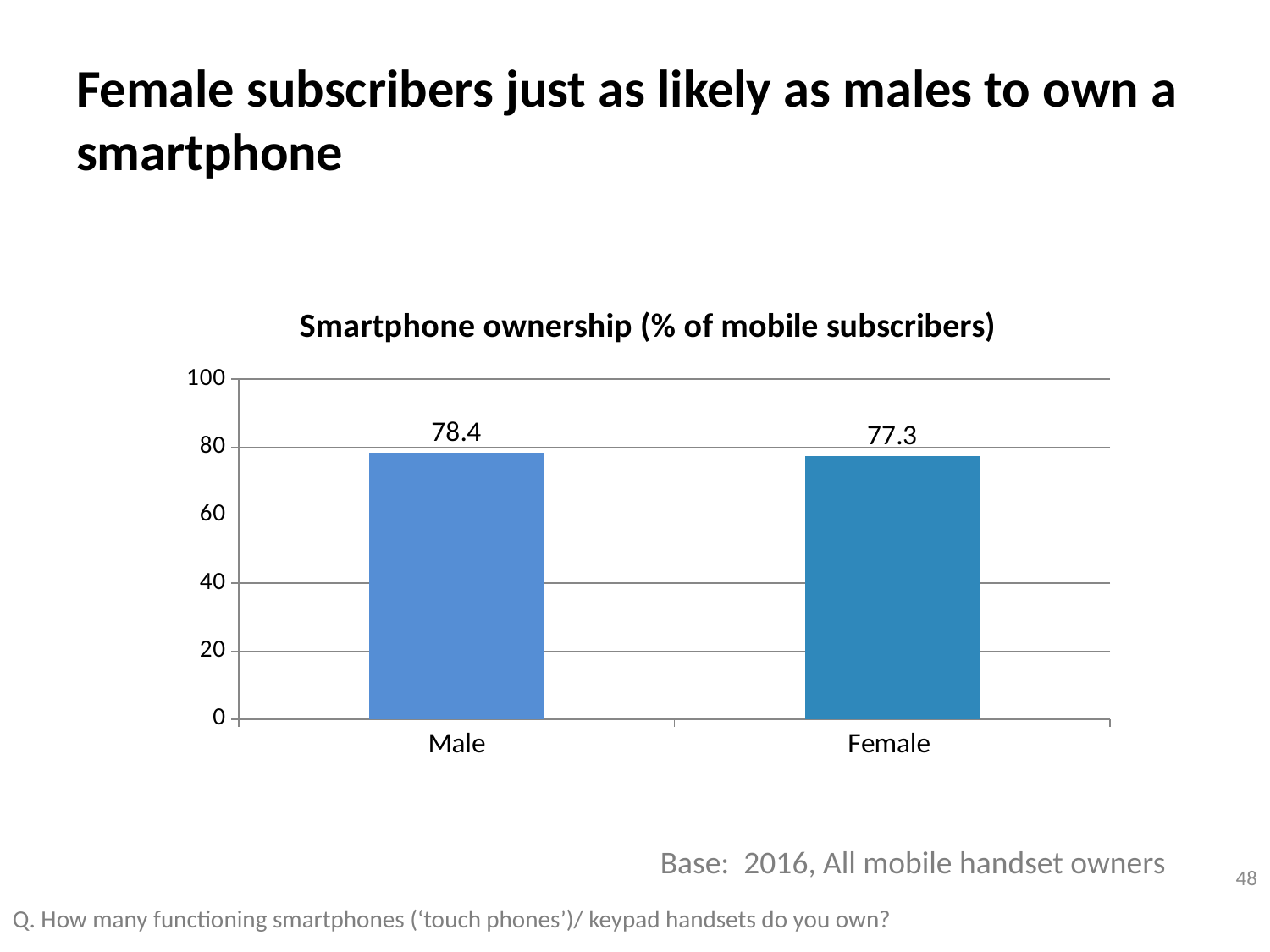
What is the difference between the Male and Female smartphone ownership values? 1.1 Is the smartphone ownership value for Male greater or less than 60? greater What is the title of the chart? Smartphone ownership (% of mobile subscribers) Is the smartphone ownership value for Female greater or less than 80? less Which category has the lower smartphone ownership value? Female Which category has the higher smartphone ownership value? Male What is the smartphone ownership value for Female? 77.3 What is the maximum value shown on the chart's vertical axis? 100 What kind of chart is shown on the slide? bar chart What is the smartphone ownership value for Male? 78.4 How many categories are shown on the x axis of the chart? 2